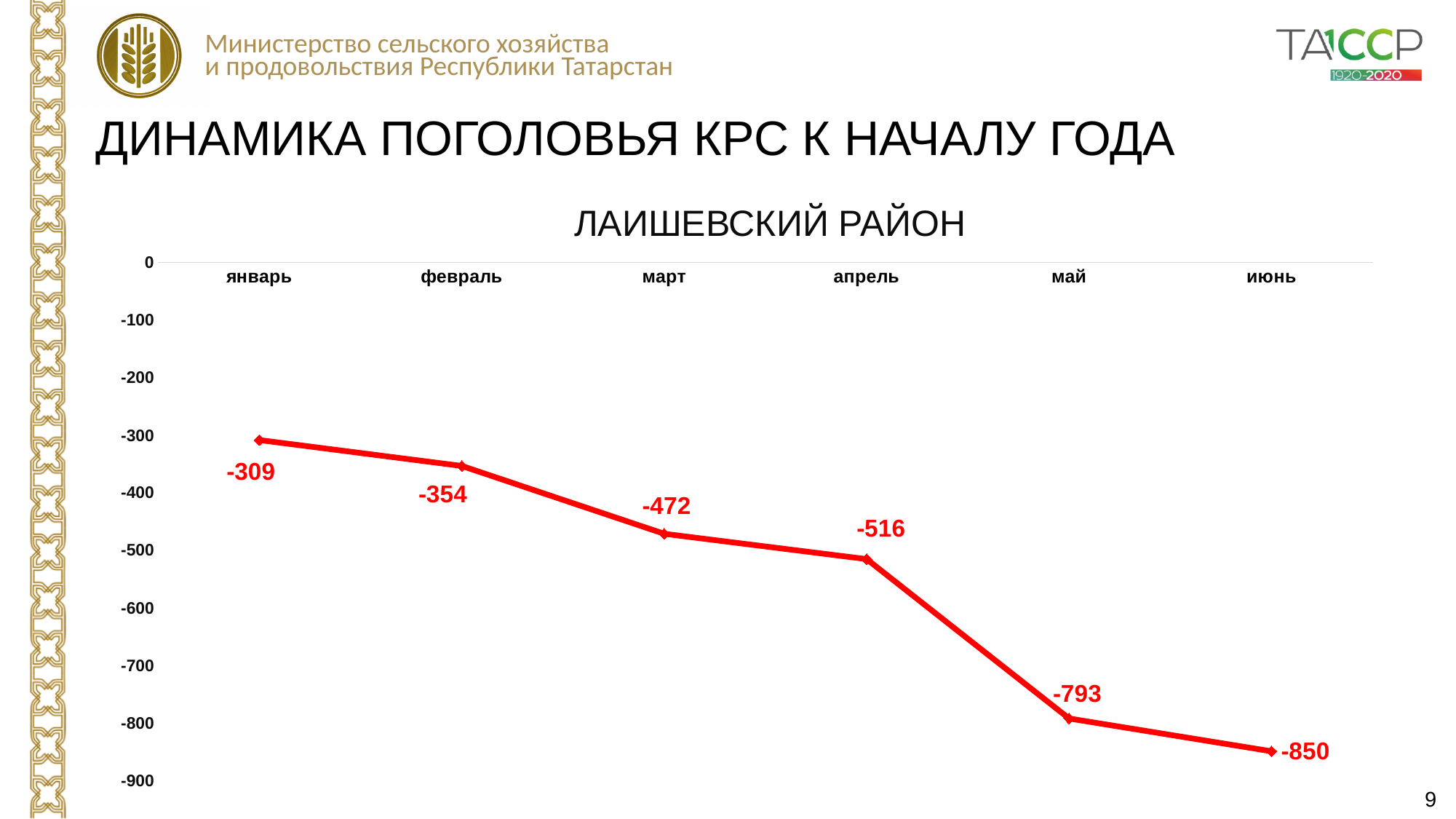
Do the values rise or fall from январь to июнь? fall What is the value for январь? -309 What is the value for июнь? -850 What is the difference between the values for май and апрель? 277 What kind of chart is shown? line chart How many months are plotted on the chart? 6 What is the title of the chart? ЛАИШЕВСКИЙ РАЙОН What is the difference between the values for февраль and март? 118 Which month has the highest value? январь What is the value for апрель? -516 Which month has the lowest value? июнь Which is larger, the value for март or the value for май? март